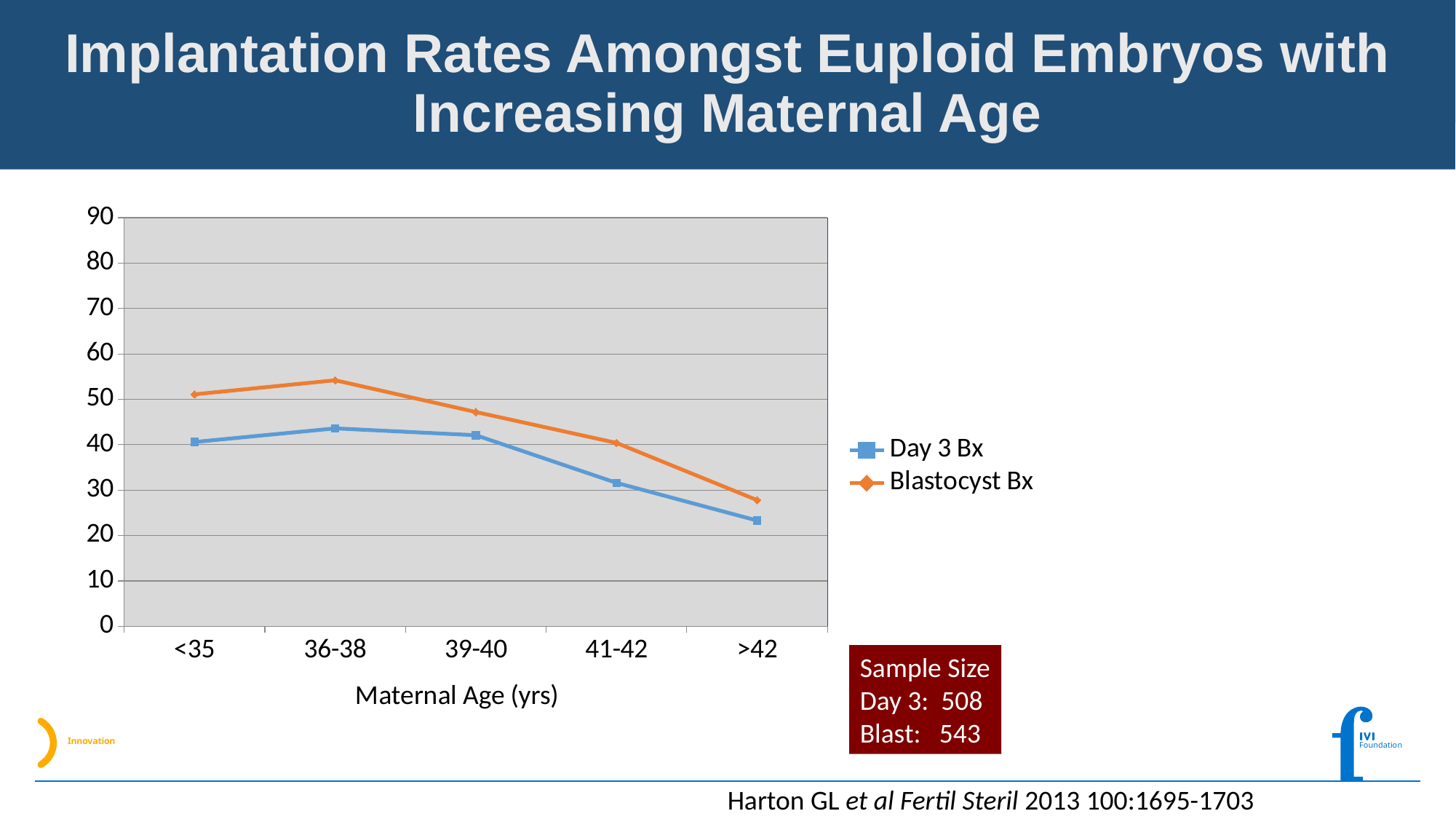
From maternal age 36-38 to >42, do the values for the Day 3 Bx series rise or fall? fall How many maternal age categories are shown on the x axis? 5 What kind of chart is shown on the slide? line chart Is the value for Day 3 Bx at maternal age 41-42 greater or less than 40? less Which maternal age category has the lowest value for the Blastocyst Bx series? >42 Which maternal age category has the highest value for the Blastocyst Bx series? 36-38 Which maternal age category has the lowest value for the Day 3 Bx series? >42 How many series does the legend list? 2 What is the label of the x axis? Maternal Age (yrs) At maternal age 39-40, which series has the larger value, Day 3 Bx or Blastocyst Bx? Blastocyst Bx Is the value for Day 3 Bx at maternal age >42 greater or less than 30? less